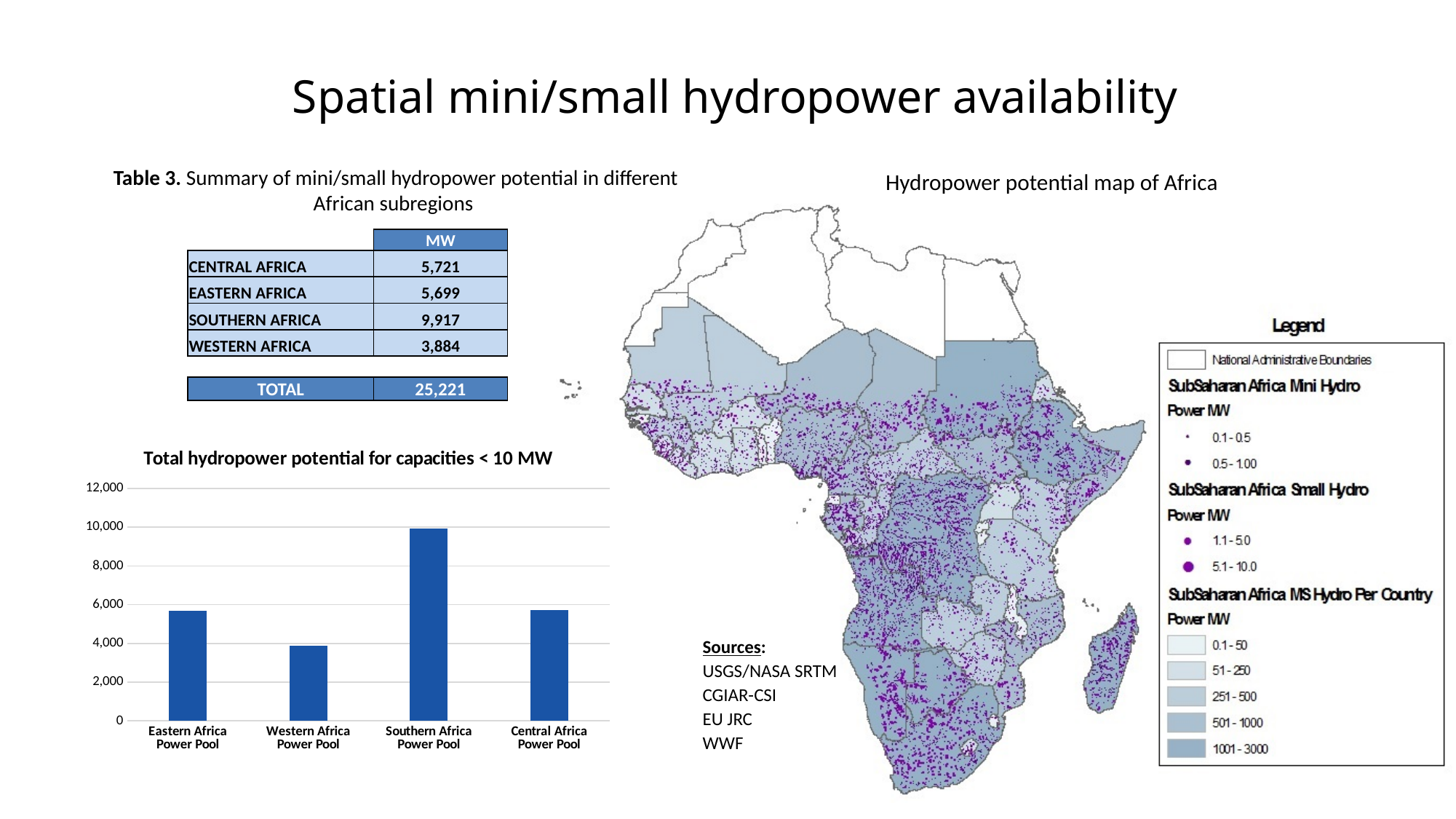
What is the highest value shown on the y axis of the bar chart "Total hydropower potential for capacities < 10 MW"? 12,000 In the bar chart "Total hydropower potential for capacities < 10 MW", which is larger: Southern Africa Power Pool or Western Africa Power Pool? Southern Africa Power Pool In the bar chart "Total hydropower potential for capacities < 10 MW", is the value for Western Africa Power Pool greater or less than 6,000? less In the bar chart "Total hydropower potential for capacities < 10 MW", which power pool has the highest value? Southern Africa Power Pool In the bar chart "Total hydropower potential for capacities < 10 MW", is the value for Eastern Africa Power Pool greater or less than 4,000? greater What kind of chart is "Total hydropower potential for capacities < 10 MW"? bar chart In the bar chart "Total hydropower potential for capacities < 10 MW", is the value for Central Africa Power Pool greater or less than 8,000? less In the bar chart "Total hydropower potential for capacities < 10 MW", which power pool has the lowest value? Western Africa Power Pool How many power pools are shown in the bar chart "Total hydropower potential for capacities < 10 MW"? 4 What is the title of the bar chart on the left of the slide? Total hydropower potential for capacities < 10 MW In the bar chart "Total hydropower potential for capacities < 10 MW", which is larger: Central Africa Power Pool or Western Africa Power Pool? Central Africa Power Pool